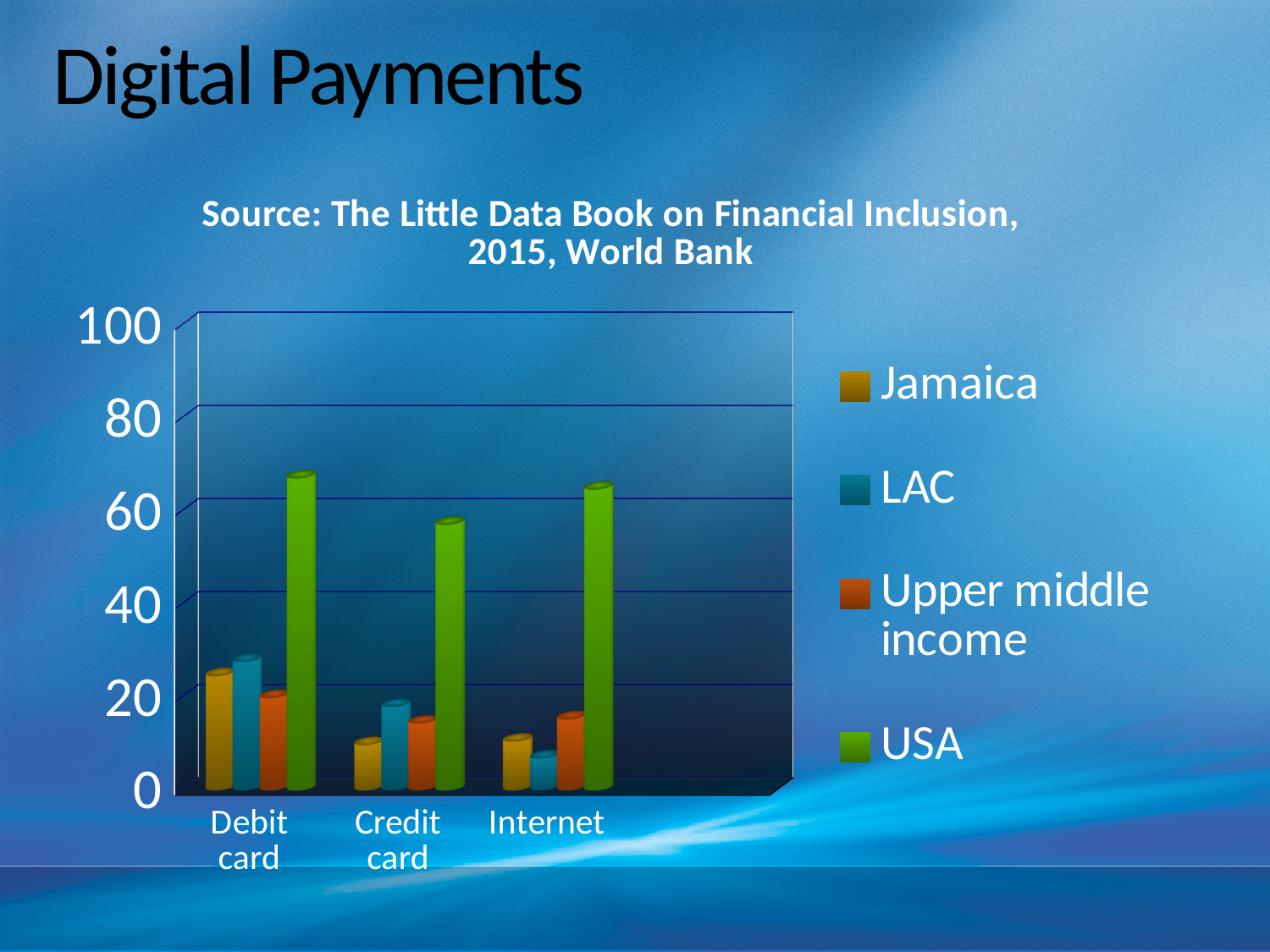
How many categories are shown on the x axis of the chart? 3 Is the value for USA in the Debit card category greater or less than 60? greater Is the value for LAC in the Internet category greater or less than 20? less Which series has the highest value for Debit card? USA What kind of chart is shown on the slide? Bar chart Is the value for USA in the Credit card category greater or less than 40? greater What is the source cited above the chart? The Little Data Book on Financial Inclusion, 2015, World Bank For Debit card, which is larger: the value for USA or the value for Jamaica? USA Which series has the lowest value for Credit card? Jamaica How many series does the chart's legend list? 4 Which series has the highest value for Credit card? USA